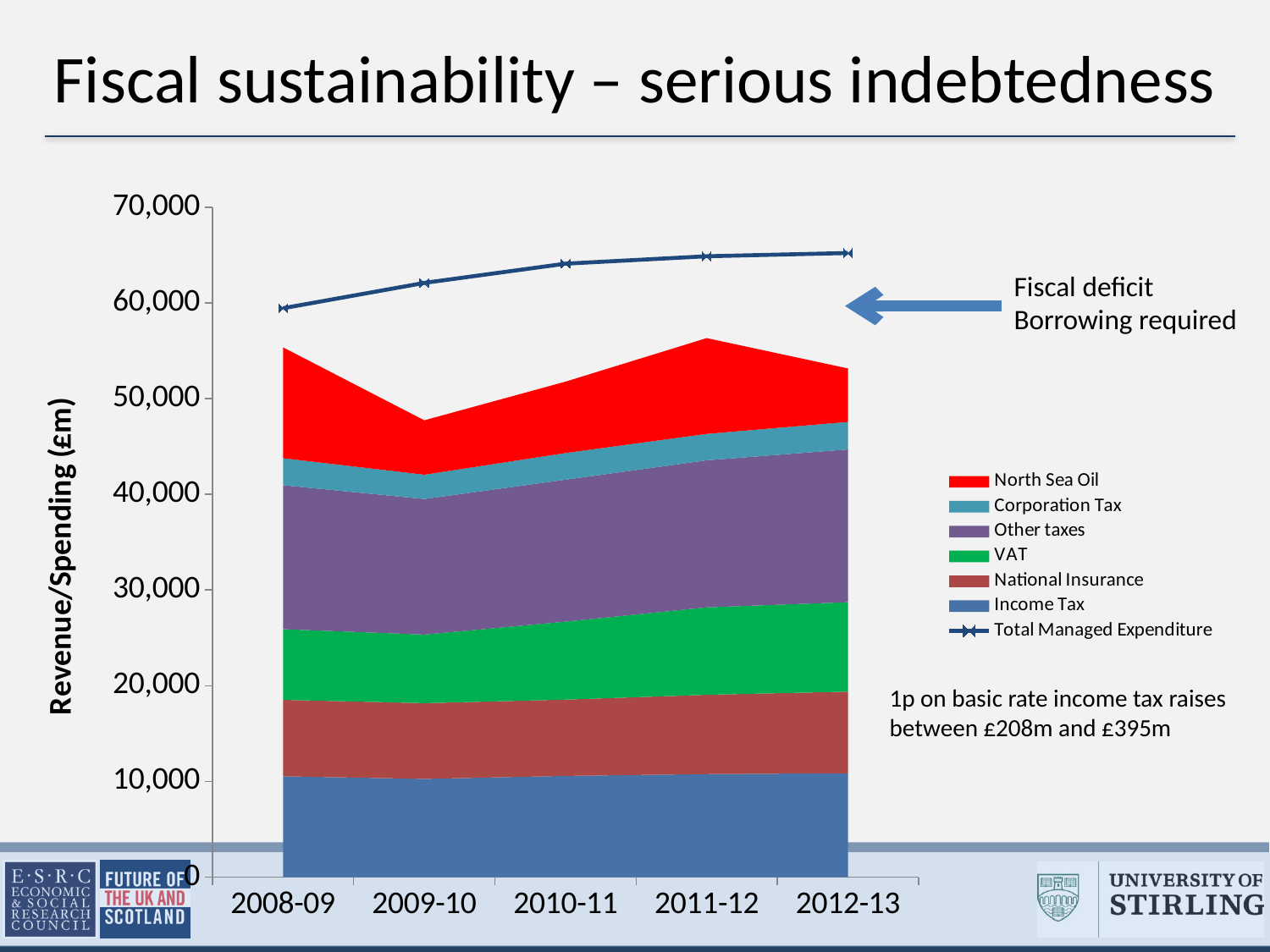
Is the value of Total Managed Expenditure in 2012-13 greater or less than 60,000? greater Which series forms the bottom layer of the stacked area? Income Tax How many years are shown on the x axis? 5 What is the label on the y axis? Revenue/Spending (£m) Does Total Managed Expenditure rise or fall from 2008-09 to 2012-13? Rises Which series is plotted as a line with markers rather than as a stacked area? Total Managed Expenditure What kind of chart is shown on the slide? A stacked area chart with a line series In which year is the total stacked revenue lowest? 2009-10 How many series does the legend list? 7 In 2010-11, which is larger: Total Managed Expenditure or the total stacked revenue? Total Managed Expenditure Is the total stacked revenue in 2009-10 greater or less than 50,000? less Is the total stacked revenue in 2011-12 greater or less than 50,000? greater